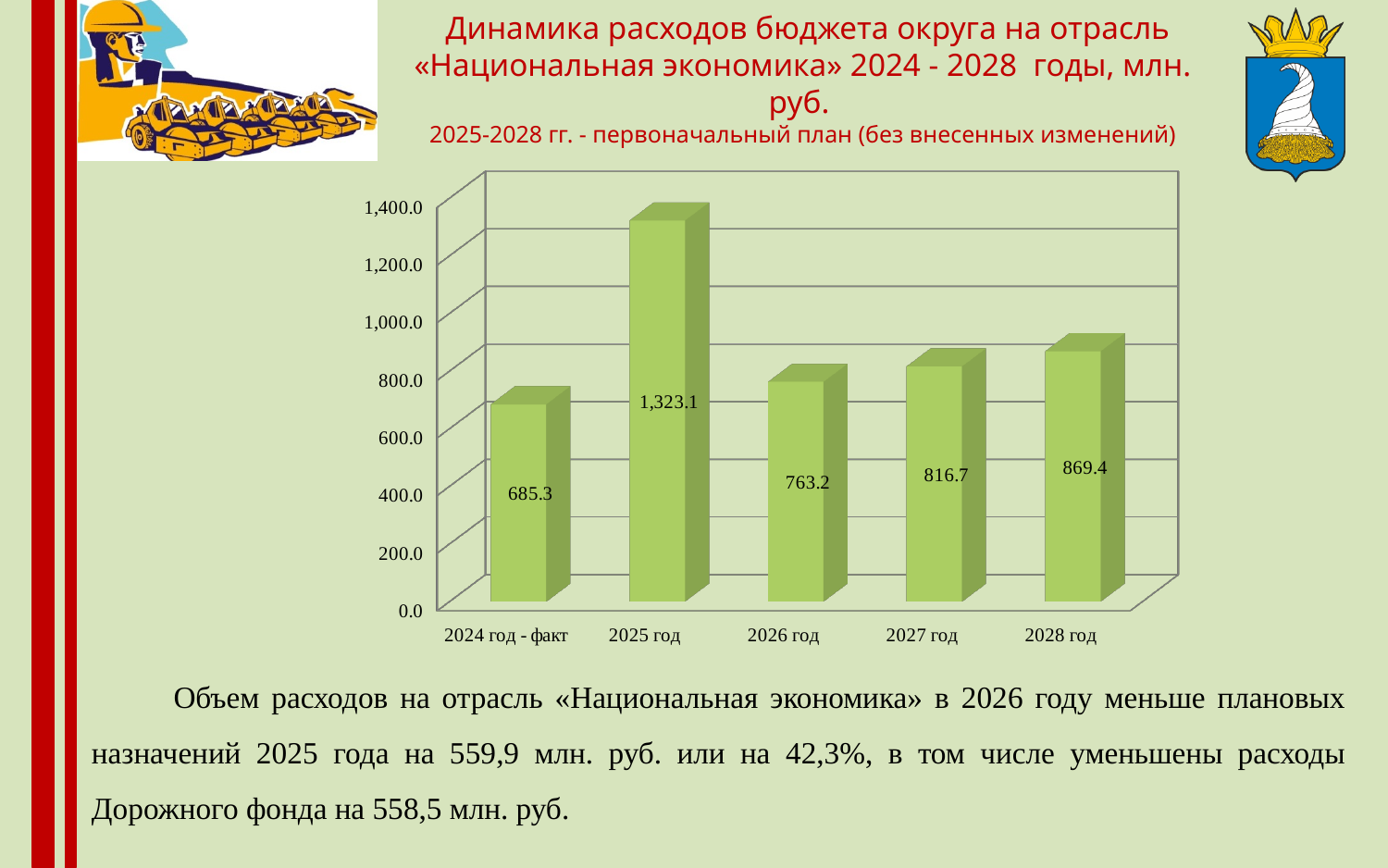
What is the value for 2025 год? 1,323.1 How many years are shown on the chart? 5 What is the difference between the values for 2028 год and 2027 год? 52.7 Is the value for 2028 год greater or less than 800.0? greater What kind of chart is shown on the slide? bar chart What is the difference between the values for 2025 год and 2026 год? 559.9 Do the values rise or fall from 2026 год to 2028 год? rise What is the value for 2028 год? 869.4 What is the value for 2024 год - факт? 685.3 Which is larger, the value for 2027 год or the value for 2026 год? 2027 год Which year has the lowest value? 2024 год - факт Which year has the highest value? 2025 год